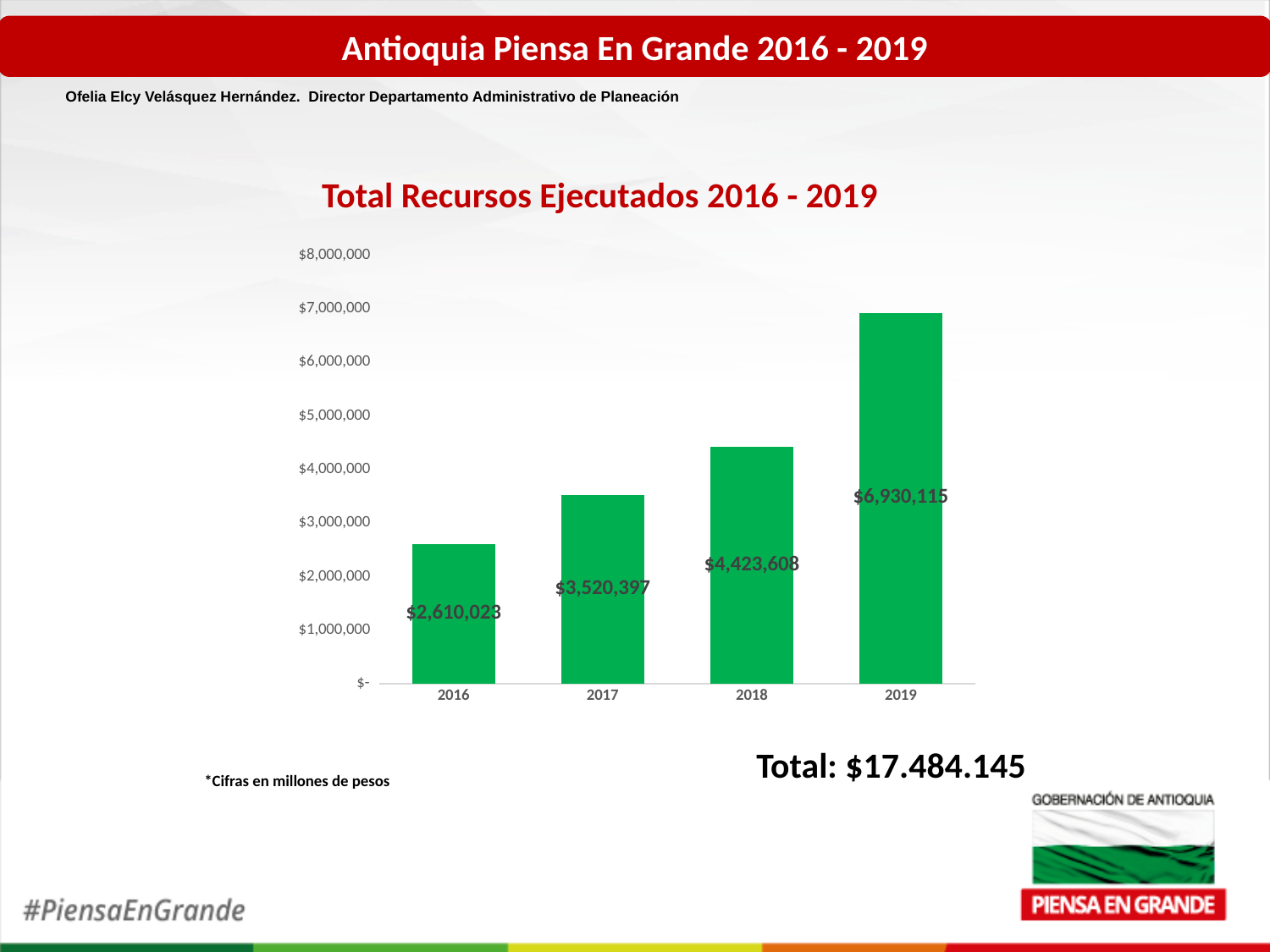
What is the value for 2016? $2,610,023 What is the difference between the values for 2019 and 2018? $2,506,507 Do the values rise or fall from 2016 to 2019? Rise What is the value for 2019? $6,930,115 What kind of chart is this? Bar chart What is the difference between the values for 2017 and 2016? $910,374 Which year has the lowest value? 2016 What is the value for 2018? $4,423,608 Which is larger, the value for 2017 or the value for 2018? 2018 What is the value for 2017? $3,520,397 Which year has the highest value? 2019 How many years are shown on the x axis? 4